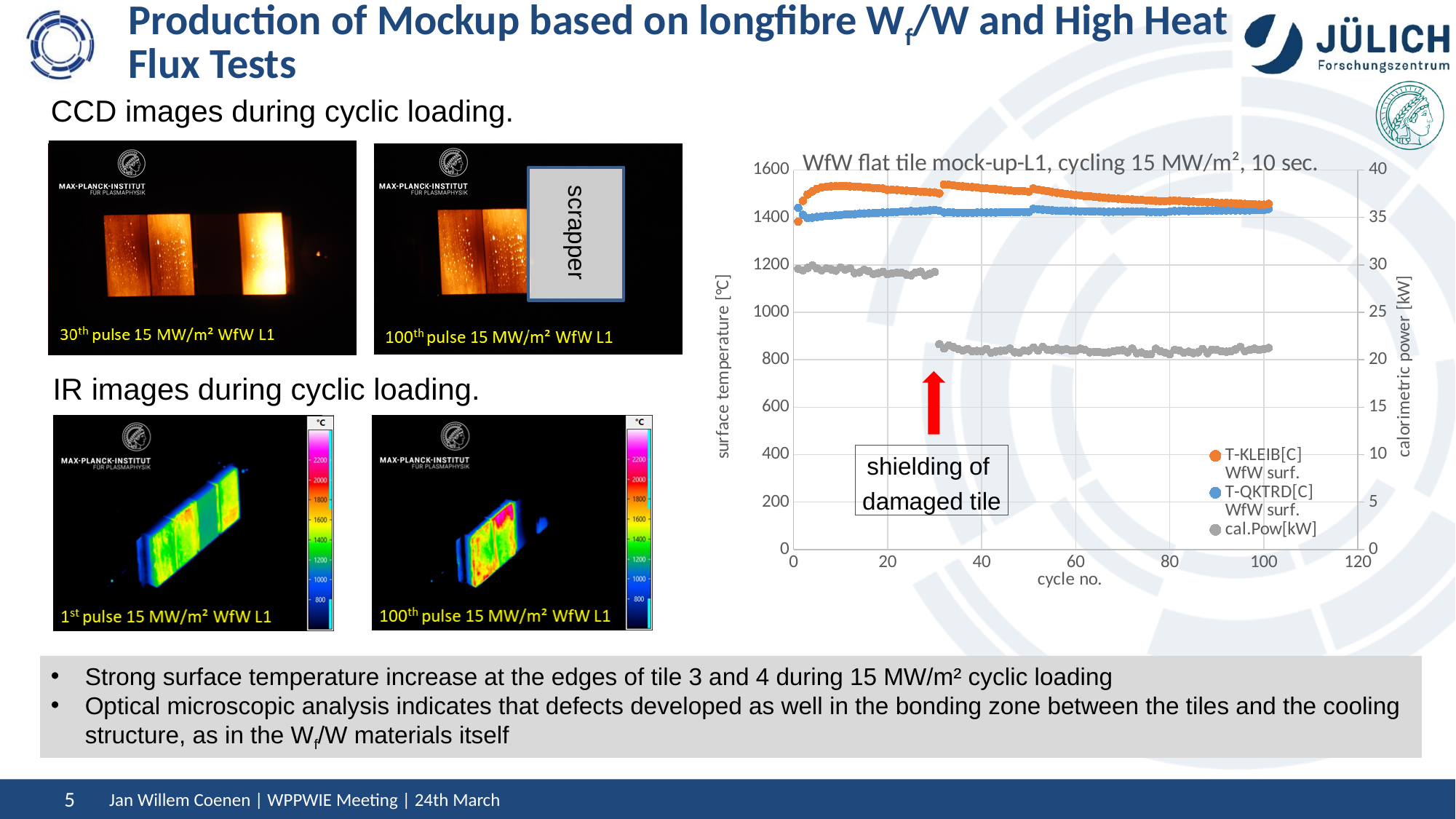
Is the T-QKTRD[C] WfW surf. value at cycle 60 greater or less than 1600? less Is the cal.Pow[kW] value at cycle 60 greater or less than 25 kW? less What is the title of the chart? WfW flat tile mock-up-L1, cycling 15 MW/m², 10 sec. Does the T-KLEIB[C] WfW surf. temperature rise or fall between cycle 30 and cycle 100? fall What kind of chart is shown on the slide? scatter chart At cycle 20, which series has the higher surface temperature, T-KLEIB[C] WfW surf. or T-QKTRD[C] WfW surf.? T-KLEIB[C] WfW surf. Is the T-KLEIB[C] WfW surf. value at cycle 20 greater or less than 1400? greater How many series does the chart legend list? 3 Does the cal.Pow[kW] series rise or fall between cycle 20 and cycle 40? fall What quantity is plotted on the right-hand vertical axis of the chart? calorimetric power [kW]